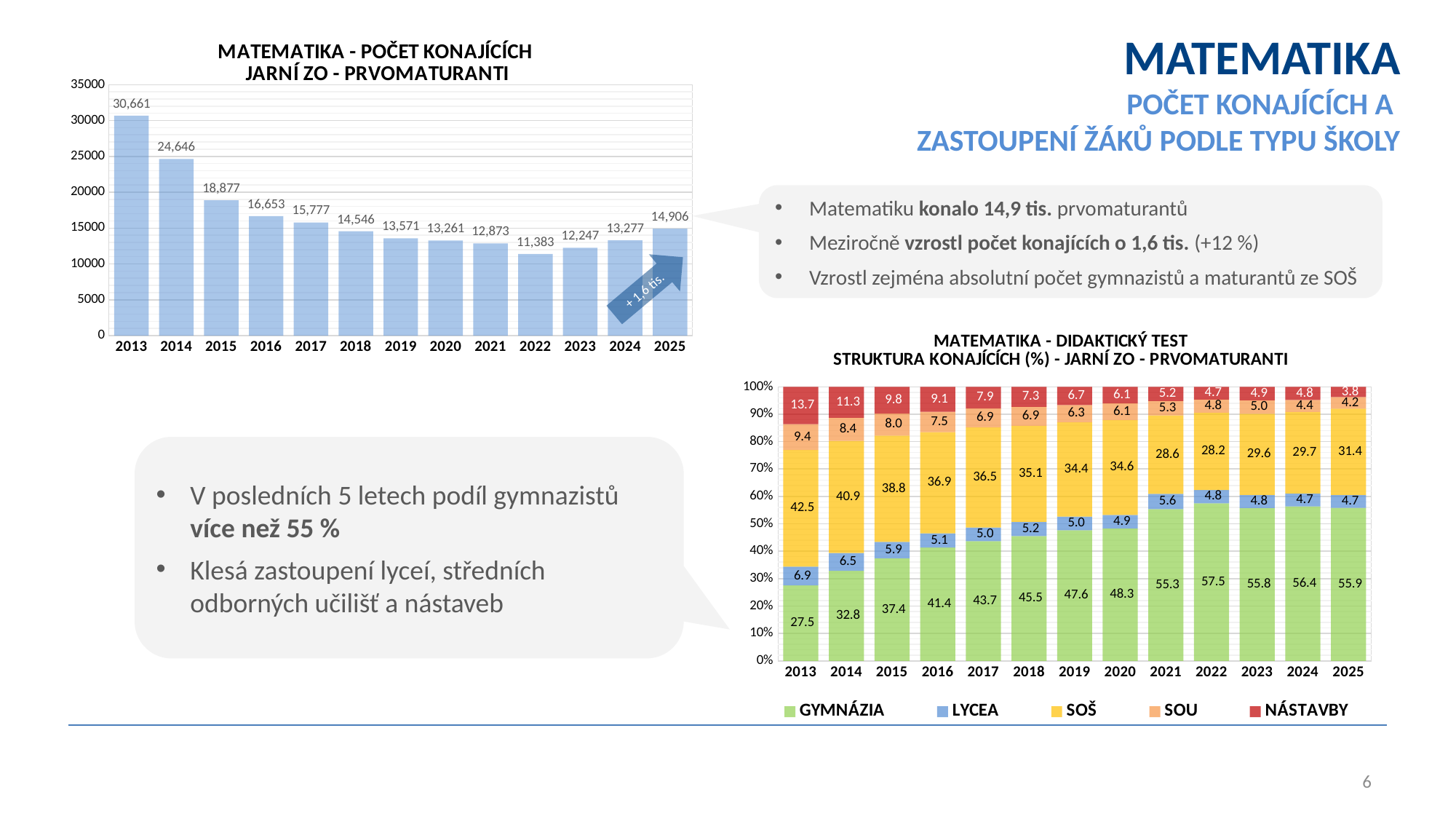
In the chart titled 'MATEMATIKA - DIDAKTICKÝ TEST STRUKTURA KONAJÍCÍCH (%)', which is larger in 2013: the value for GYMNÁZIA or the value for SOŠ? SOŠ In the chart titled 'MATEMATIKA - POČET KONAJÍCÍCH JARNÍ ZO - PRVOMATURANTI', do the values rise or fall from 2013 to 2022? fall In the chart titled 'MATEMATIKA - POČET KONAJÍCÍCH JARNÍ ZO - PRVOMATURANTI', which year has the highest value? 2013 In the chart titled 'MATEMATIKA - DIDAKTICKÝ TEST STRUKTURA KONAJÍCÍCH (%)', what is the value for GYMNÁZIA in 2025? 55.9 In the chart titled 'MATEMATIKA - DIDAKTICKÝ TEST STRUKTURA KONAJÍCÍCH (%)', what is the value for NÁSTAVBY in 2013? 13.7 In the chart titled 'MATEMATIKA - POČET KONAJÍCÍCH JARNÍ ZO - PRVOMATURANTI', what is the difference between the values for 2025 and 2024? 1,629 In the chart titled 'MATEMATIKA - POČET KONAJÍCÍCH JARNÍ ZO - PRVOMATURANTI', how many years are shown on the x axis? 13 In the chart titled 'MATEMATIKA - DIDAKTICKÝ TEST STRUKTURA KONAJÍCÍCH (%)', how many series does the legend list? 5 In the chart titled 'MATEMATIKA - POČET KONAJÍCÍCH JARNÍ ZO - PRVOMATURANTI', what kind of chart is it? bar chart In the chart titled 'MATEMATIKA - POČET KONAJÍCÍCH JARNÍ ZO - PRVOMATURANTI', what is the value for 2025? 14,906 In the chart titled 'MATEMATIKA - POČET KONAJÍCÍCH JARNÍ ZO - PRVOMATURANTI', which year has the lowest value? 2022 In the chart titled 'MATEMATIKA - DIDAKTICKÝ TEST STRUKTURA KONAJÍCÍCH (%)', which colour represents SOŠ in the legend? yellow